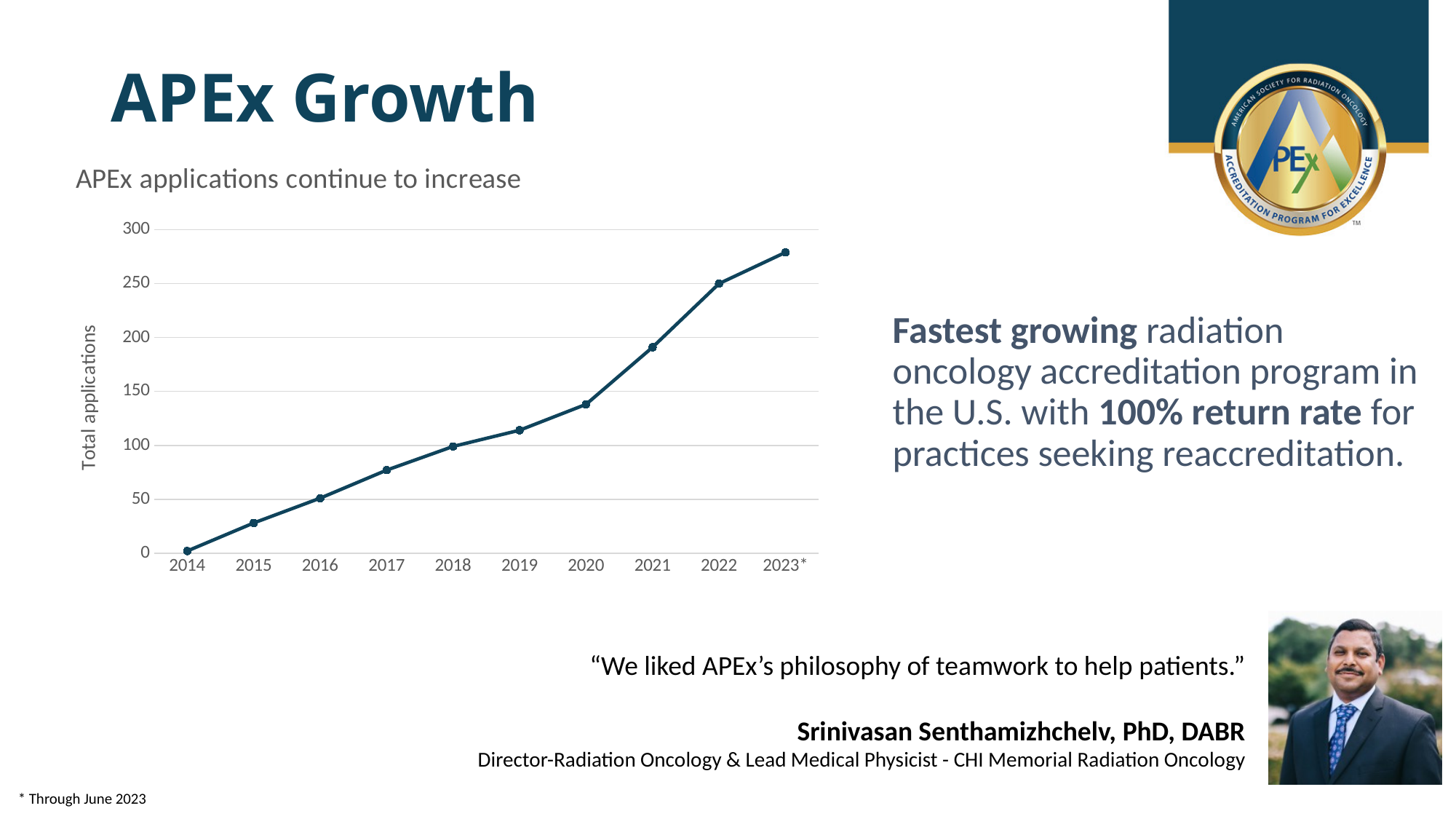
Is the value for 2023* greater or less than 250? greater Is the value for 2015 greater or less than 50? less Is the value for 2020 greater or less than 150? less What is the label on the y axis of the chart? Total applications Which year has more total applications, 2022 or 2019? 2022 Which year has the highest number of total applications? 2023* What kind of chart is shown on the slide? line chart How many years are plotted on the x axis of the chart? 10 Do total applications rise or fall from 2014 to 2023? rise Which year has the lowest number of total applications? 2014